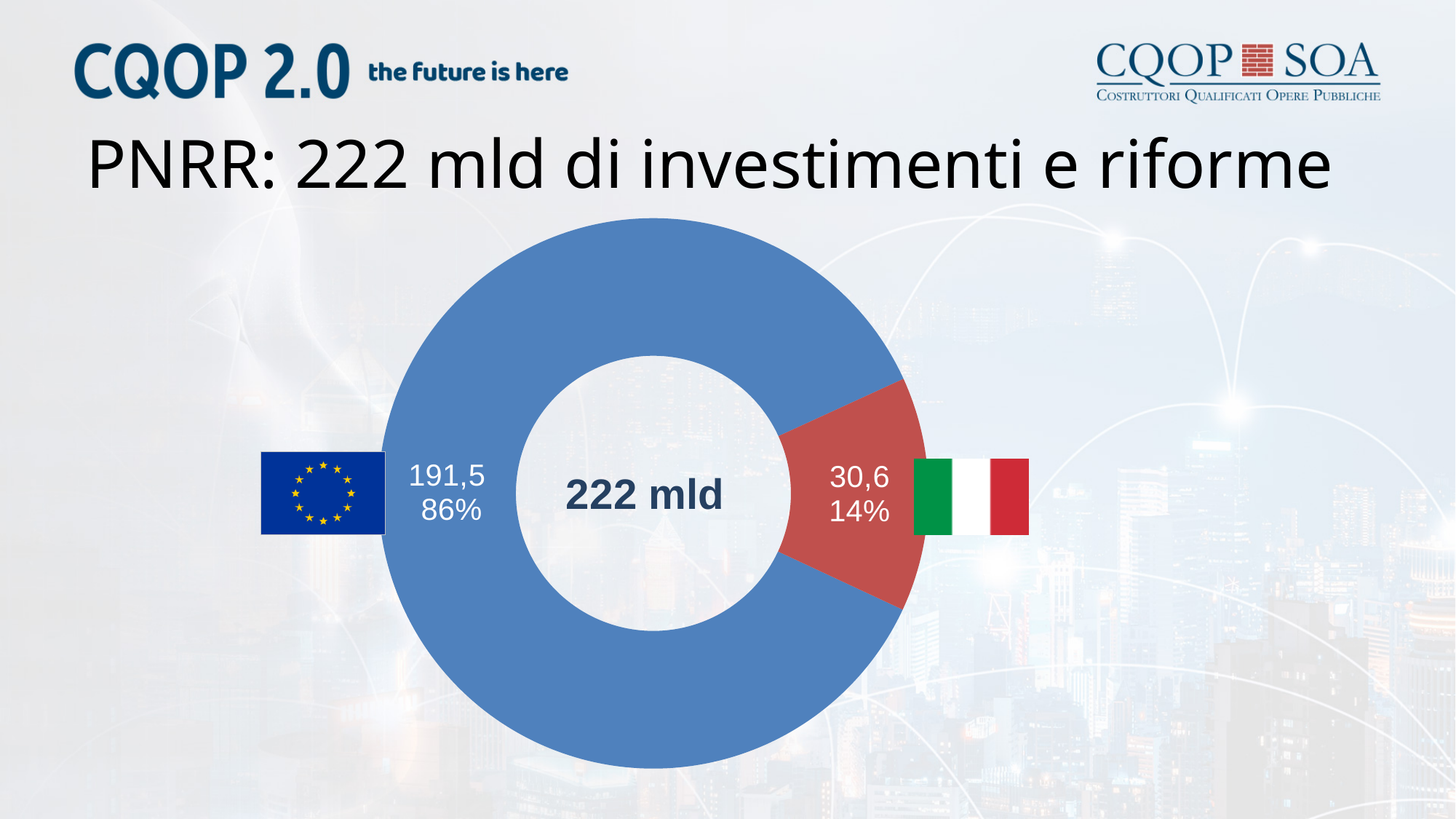
What colour is the slice marked with the Italian flag? Red What total is printed in the centre of the donut chart? 222 mld What value is shown for the slice marked with the Italian flag? 30,6 Which slice is the smallest in the chart? The Italian flag slice (30,6, 14%) How many slices does the chart have? 2 Which is larger, the EU flag slice or the Italian flag slice? The EU flag slice What percentage share does the slice marked with the EU flag have? 86% What kind of chart is shown on the slide? Donut (pie) chart What percentage share does the slice marked with the Italian flag have? 14% Which slice is the largest in the chart? The EU flag slice (191,5, 86%) What is the difference between the EU flag slice value and the Italian flag slice value? 160,9 What value is shown for the slice marked with the EU flag? 191,5